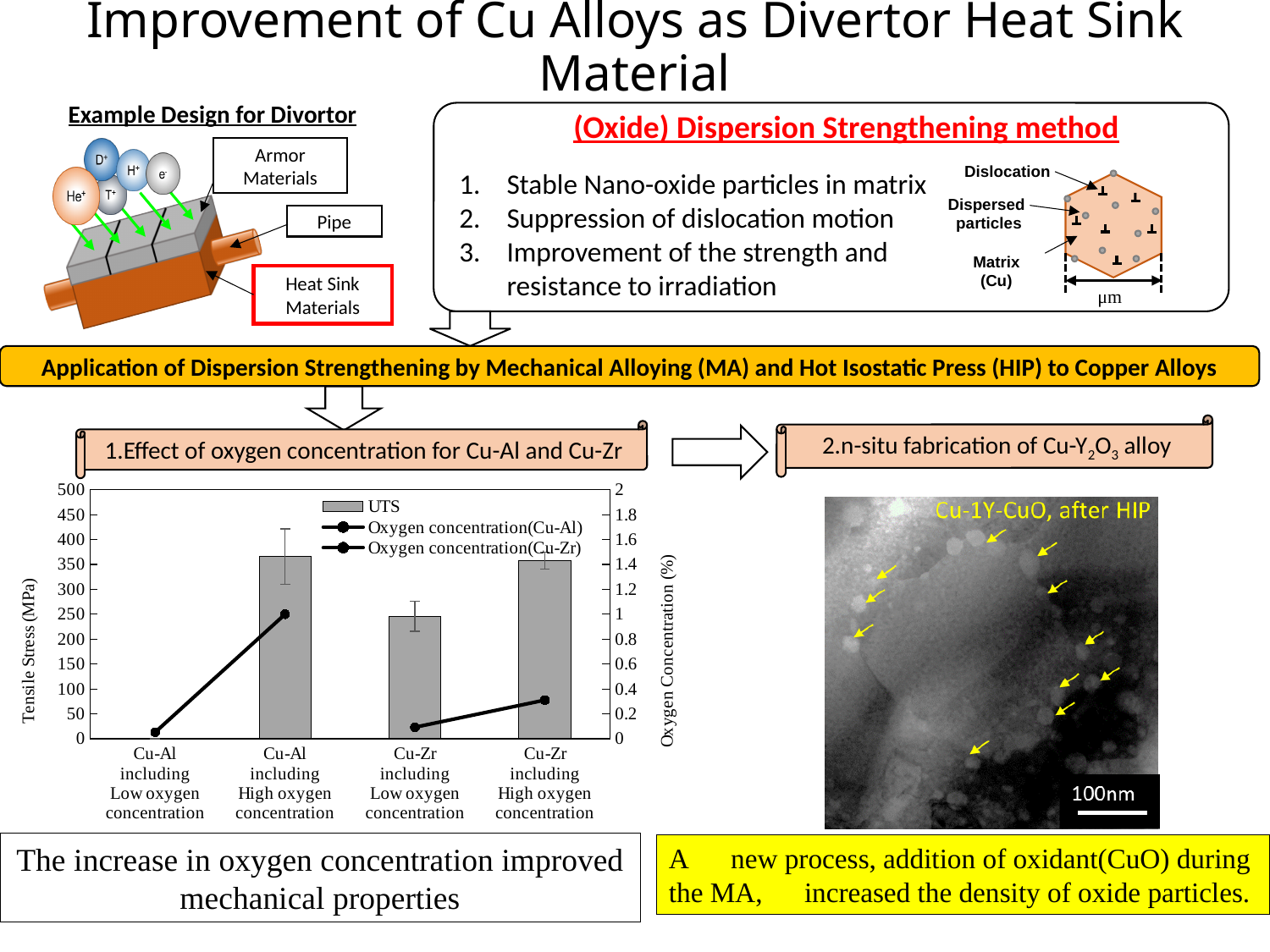
Is the UTS value for Cu-Zr including low oxygen concentration greater or less than 300 MPa? less Which has the larger UTS bar: Cu-Al including high oxygen concentration or Cu-Zr including low oxygen concentration? Cu-Al including high oxygen concentration Is the oxygen concentration for Cu-Al including high oxygen concentration greater or less than 0.8%? greater Is the UTS value for Cu-Al including high oxygen concentration greater or less than 300 MPa? greater Which has the higher oxygen concentration: Cu-Al including high oxygen concentration or Cu-Zr including high oxygen concentration? Cu-Al including high oxygen concentration What kind of chart is shown on the slide? A combined bar and line chart What is the title of the left vertical axis of the chart? Tensile Stress (MPa) Does the oxygen concentration line for Cu-Al rise or fall from the low oxygen category to the high oxygen category? rise How many series does the chart legend list? 3 How many categories are shown along the x axis of the chart? 4